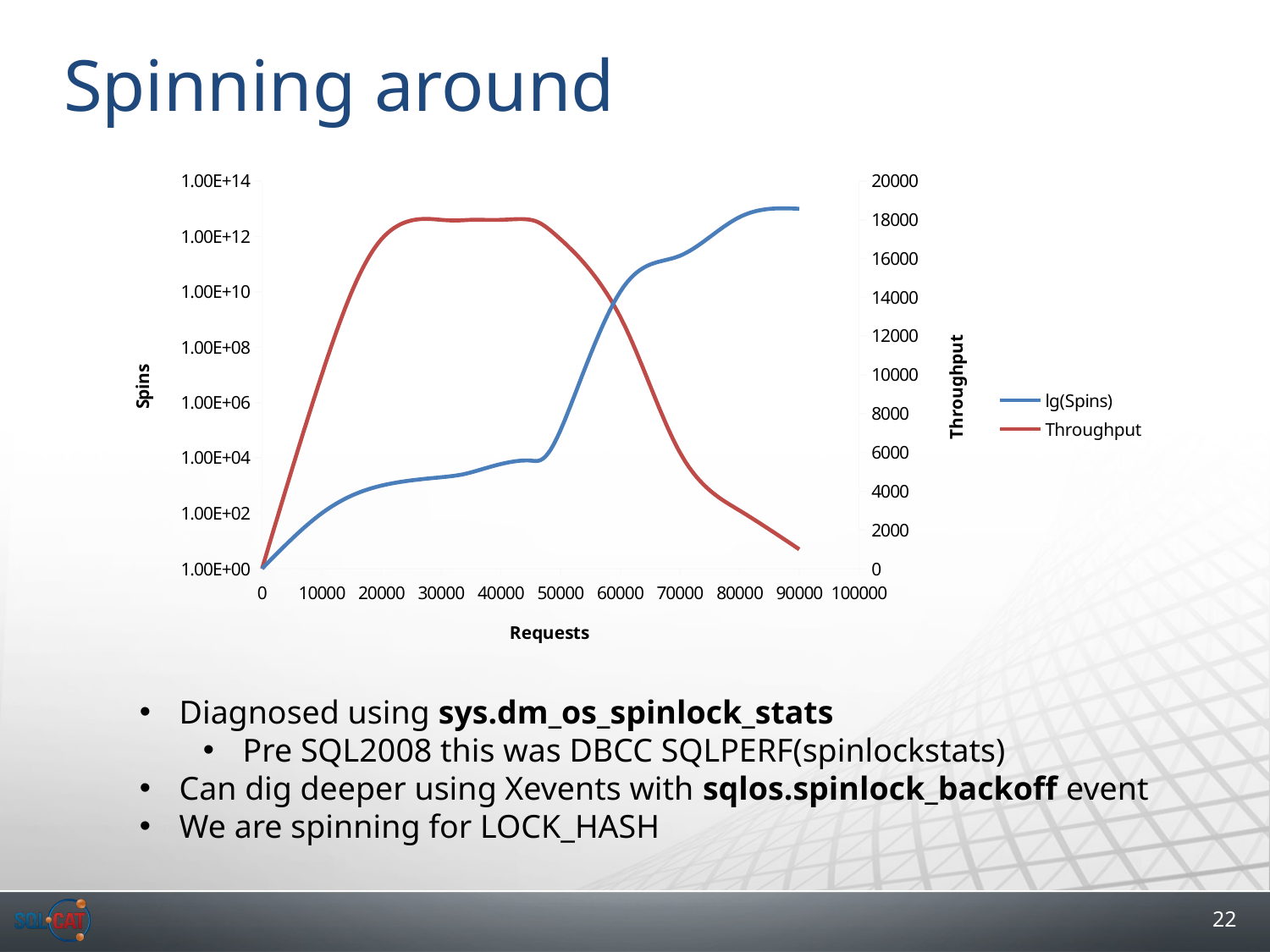
Is the Throughput value at 70000 Requests greater or less than 8000? less Is the Throughput value at 90000 Requests greater or less than 2000? less Does the Throughput series rise or fall between 50000 and 90000 Requests? fall Is the Throughput value at 60000 Requests greater or less than 10000? greater What are the two series named in the legend? lg(Spins) and Throughput Does the lg(Spins) series rise or fall as Requests increase? rise What is the title of the x axis? Requests What kind of chart is shown on the slide? line chart How many series does the legend list? 2